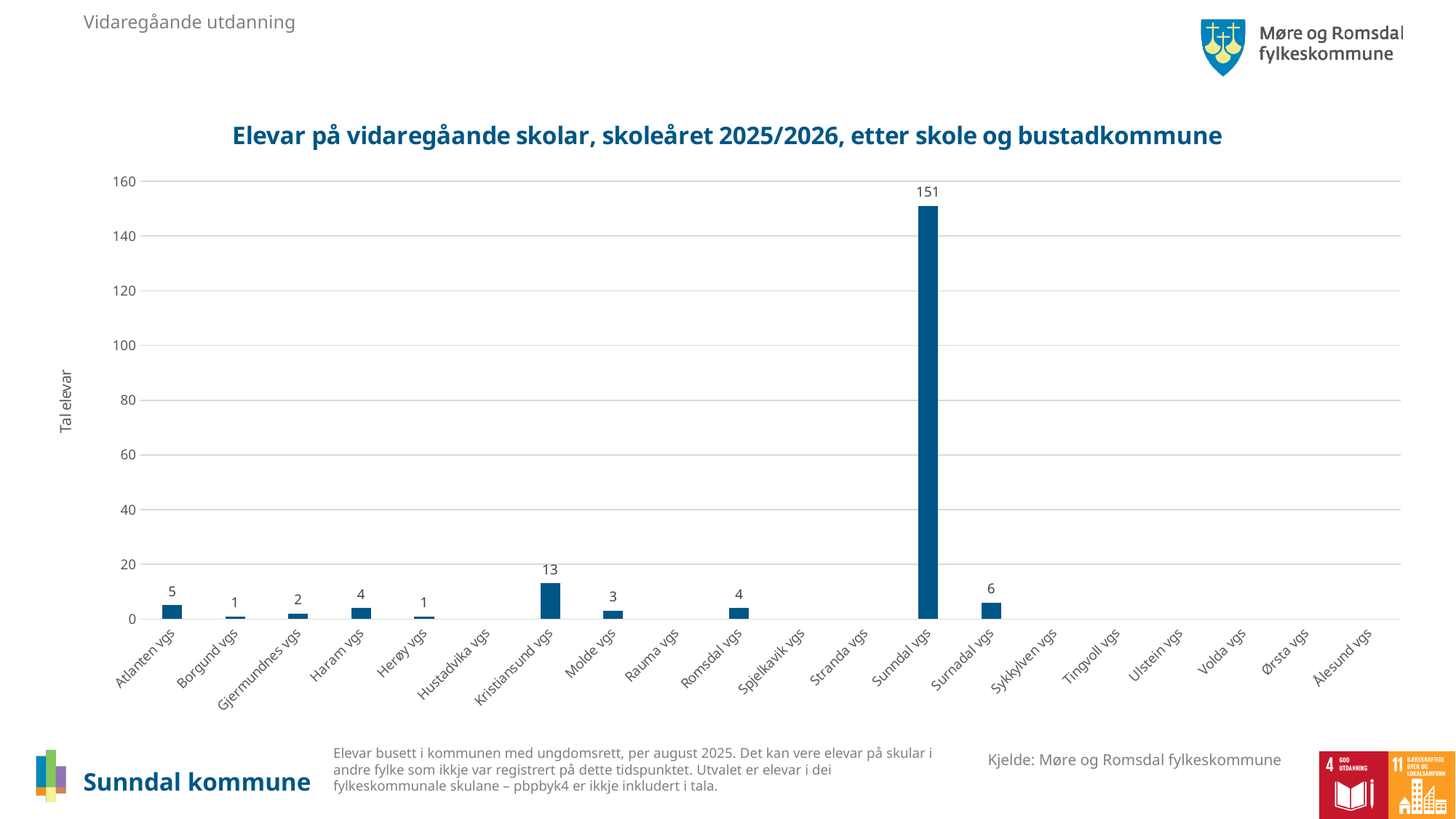
Which school has the highest number of students? Sunndal vgs What is the label of the y axis? Tal elevar Is the value for Sunndal vgs greater or less than 140? greater What kind of chart is shown on the slide? Bar chart What is the difference between the values for Kristiansund vgs and Surnadal vgs? 7 What is the value for Surnadal vgs? 6 Which is larger, the value for Surnadal vgs or the value for Atlanten vgs? Surnadal vgs How many students are shown for Sunndal vgs? 151 What is the value for Atlanten vgs? 5 How many schools are listed on the x axis? 20 What is the difference between the values for Sunndal vgs and Kristiansund vgs? 138 What is the value for Kristiansund vgs? 13